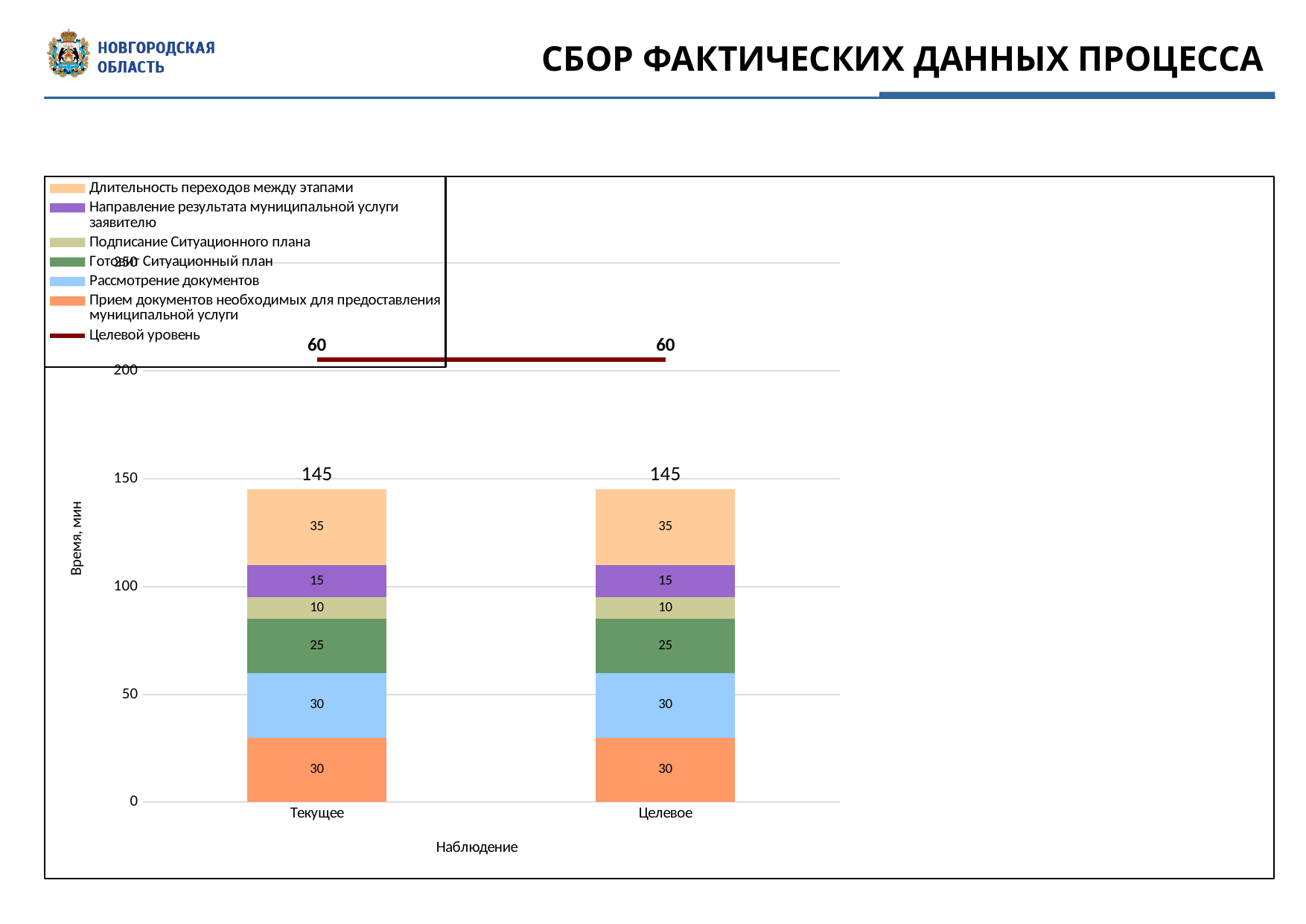
What value is labelled for the Целевой уровень line at Текущее? 60 What is the total of the stacked bar for Текущее? 145 What is the difference between the Длительность переходов между этапами segment and the Направление результата муниципальной услуги заявителю segment for Текущее? 20 How many categories are shown on the x axis? 2 What is the total of the stacked bar for Целевое? 145 What is the label of the vertical axis? Время, мин What is the value of the Рассмотрение документов segment for Целевое? 30 What is the value of the Подписание Ситуационного плана segment for Текущее? 10 How many entries does the legend list? 7 What is the value of the Длительность переходов между этапами segment for Текущее? 35 What kind of chart is shown on the slide? stacked bar chart